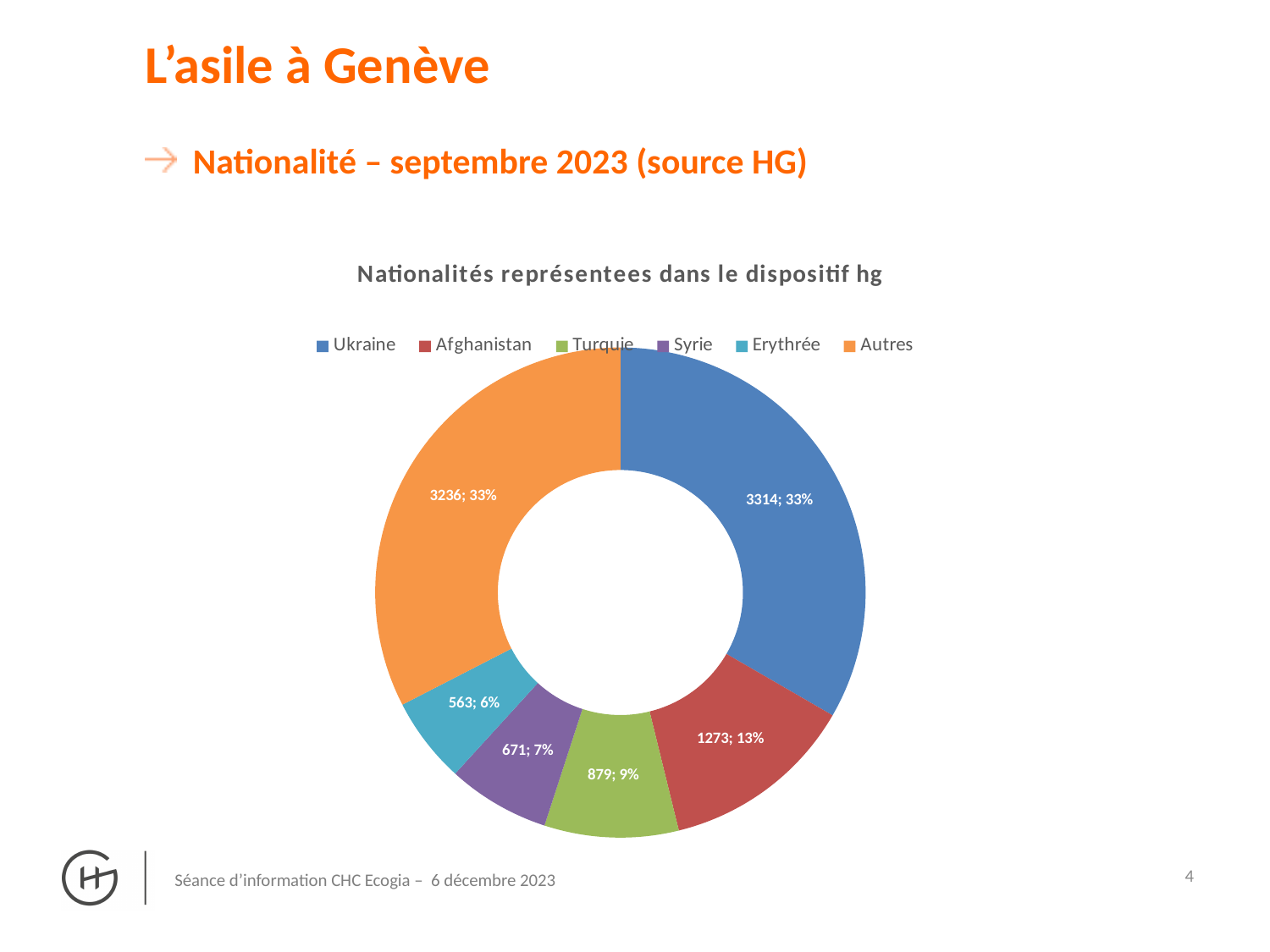
What is the value shown for Afghanistan? 1273 What kind of chart is shown on the slide? Doughnut (pie) chart Which category has the lowest value? Erythrée What percentage share is shown for Turquie? 9% Which category has the highest value? Ukraine Which is larger, the value for Turquie or the value for Syrie? Turquie What is the value shown for Syrie? 671 What percentage share is shown for Erythrée? 6% What is the difference between the values for Ukraine and Autres? 78 What is the value shown for Ukraine? 3314 What is the title of the chart? Nationalités représentees dans le dispositif hg How many categories does the chart show? 6